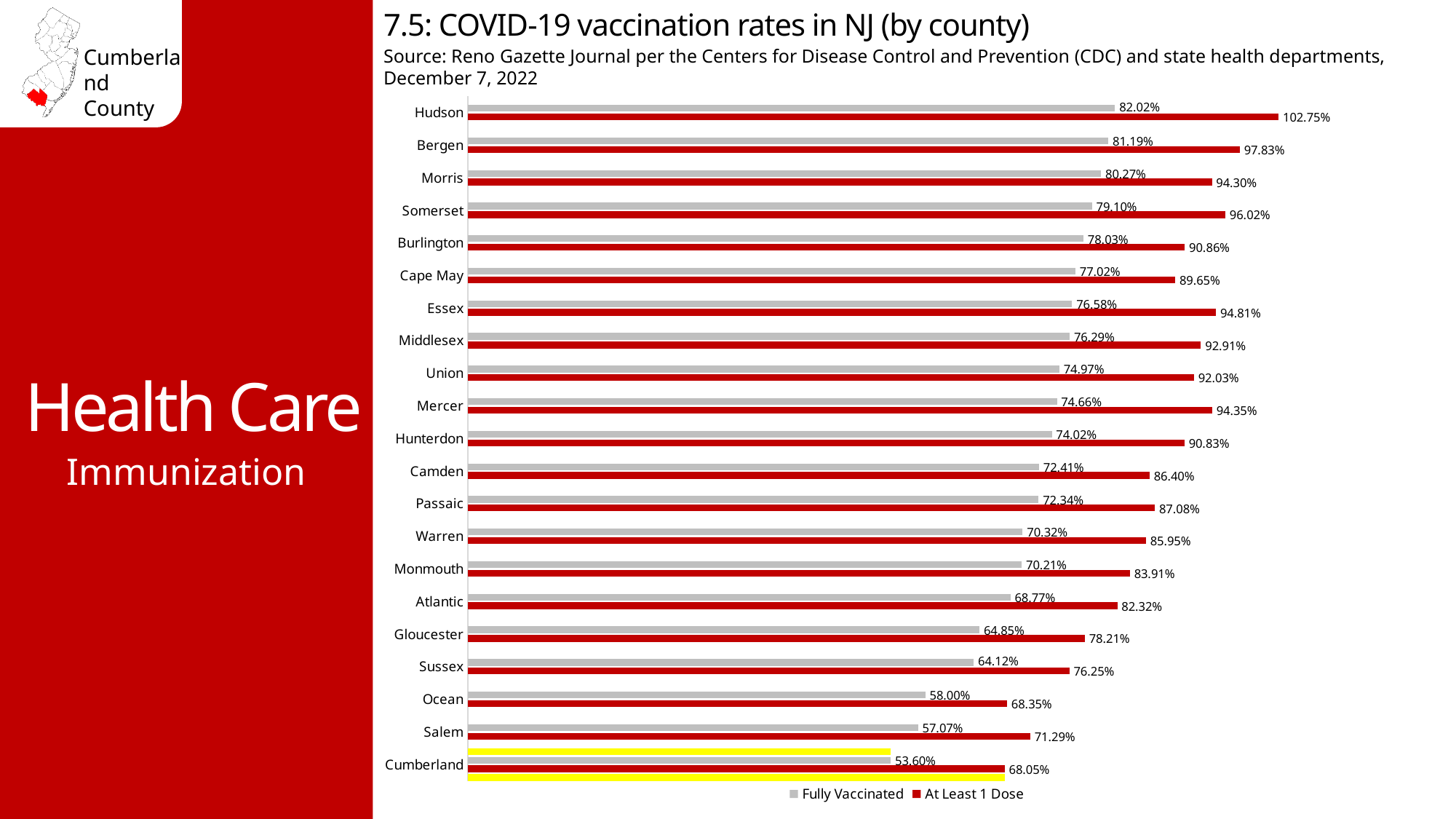
What kind of chart is shown on the slide? Bar chart Which county has the lowest Fully Vaccinated rate? Cumberland What is the Fully Vaccinated rate for Ocean County? 58.00% What is the At Least 1 Dose rate for Hudson County? 102.75% What is the Fully Vaccinated rate for Cumberland County? 53.60% Which county has the highest Fully Vaccinated rate? Hudson What are the two series named in the legend? Fully Vaccinated and At Least 1 Dose Which county has a higher At Least 1 Dose rate, Somerset or Morris? Somerset How many series does the legend list? 2 What is the difference between Cumberland County's At Least 1 Dose rate and its Fully Vaccinated rate? 14.45% What is the difference between Hudson County's At Least 1 Dose rate and its Fully Vaccinated rate? 20.73% How many counties are shown in the chart? 21